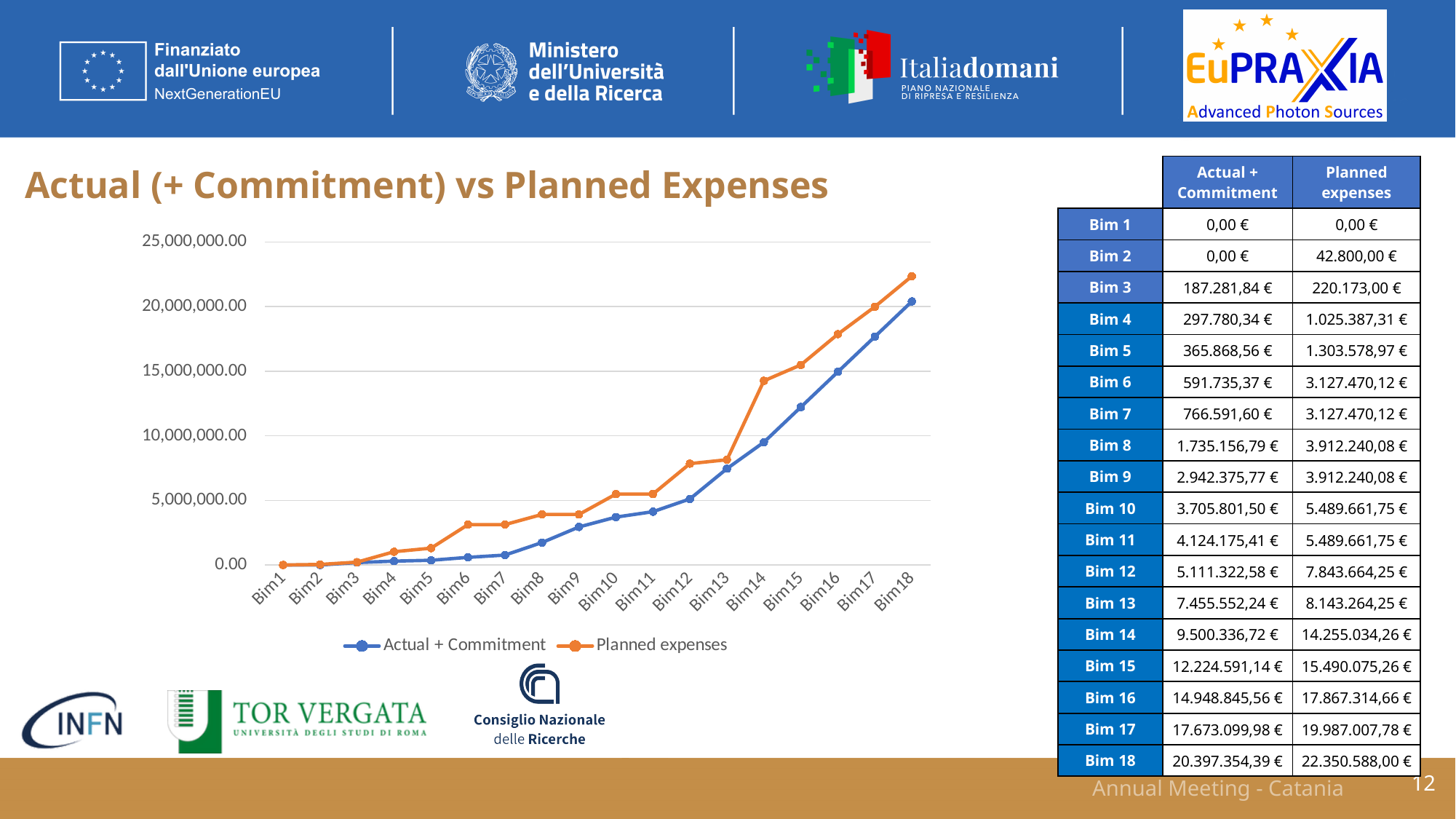
What is the value of Actual + Commitment at Bim 10? 3.705.801,50 € Which Bim period has the highest Planned expenses value? Bim 18 How many series does the chart legend list? 2 What is the value of Planned expenses at Bim 18? 22.350.588,00 € Is the value for Planned expenses at Bim12 greater or less than 10,000,000.00? less How many Bim periods are plotted along the x axis of the chart? 18 What kind of chart is shown on the slide? line chart What is the value of Actual + Commitment at Bim 18? 20.397.354,39 € Is the value for Actual + Commitment at Bim15 greater or less than 10,000,000.00? greater At Bim 14, which series has the larger value, Actual + Commitment or Planned expenses? Planned expenses Do the values of the Planned expenses series rise or fall from Bim1 to Bim18? rise What is the difference between Planned expenses and Actual + Commitment at Bim 18? 1.953.233,61 €